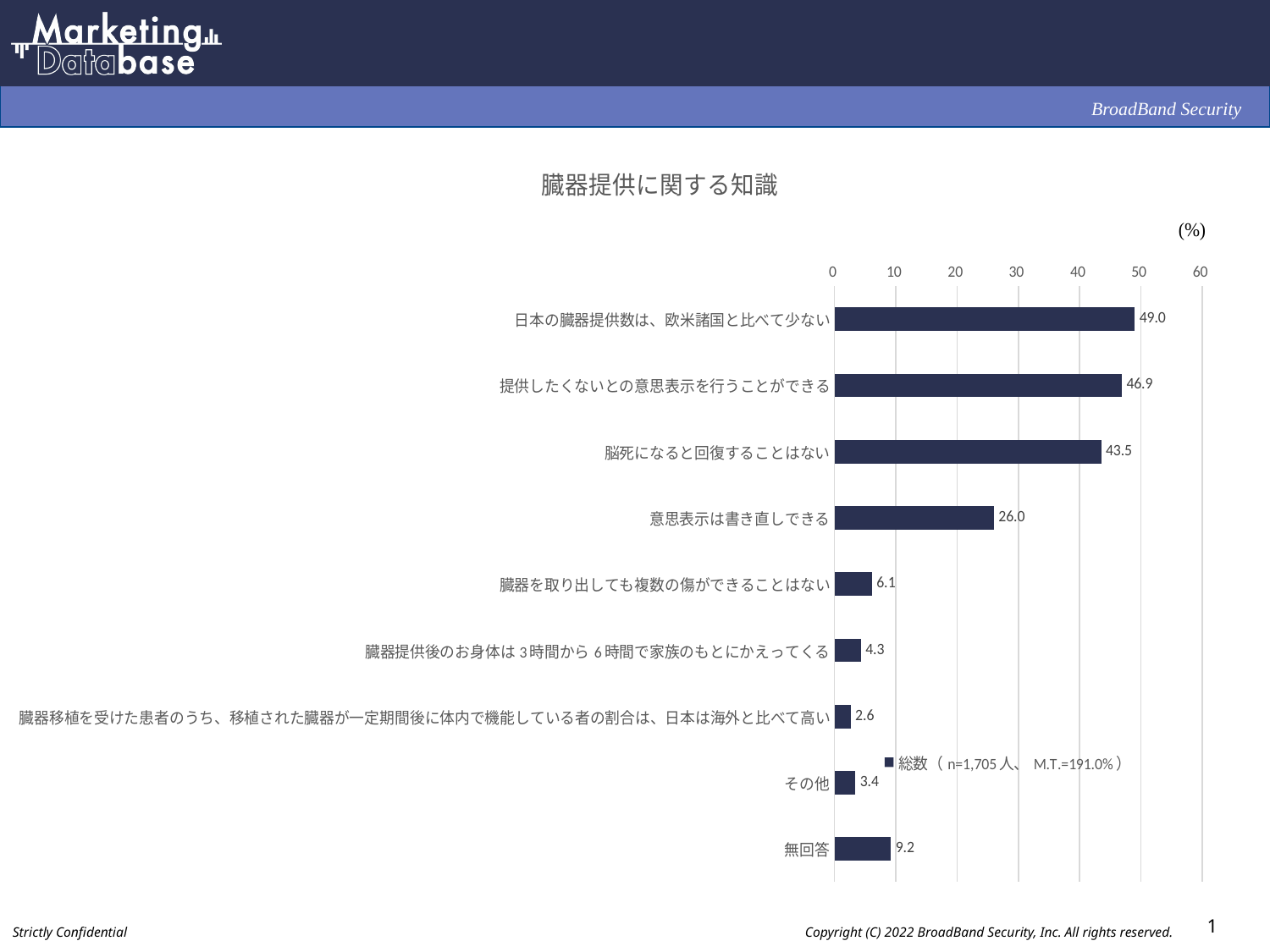
What is the value for 「脳死になると回復することはない」? 43.5 What is the difference between the values for 「日本の臓器提供数は、欧米諸国と比べて少ない」 and 「提供したくないとの意思表示を行うことができる」? 2.1 Which category has the lowest value? 臓器移植を受けた患者のうち、移植された臓器が一定期間後に体内で機能している者の割合は、日本は海外と比べて高い What is the value for 「その他」? 3.4 Is the value for 「脳死になると回復することはない」 greater or less than 40? greater What is the value for 「無回答」? 9.2 What kind of chart is shown on the slide? Bar chart What is the value for 「日本の臓器提供数は、欧米諸国と比べて少ない」? 49.0 What is the title of the chart? 臓器提供に関する知識 How many categories are shown in the chart? 9 Which is larger, the value for 「意思表示は書き直しできる」 or the value for 「無回答」? 意思表示は書き直しできる Which category has the highest value? 日本の臓器提供数は、欧米諸国と比べて少ない